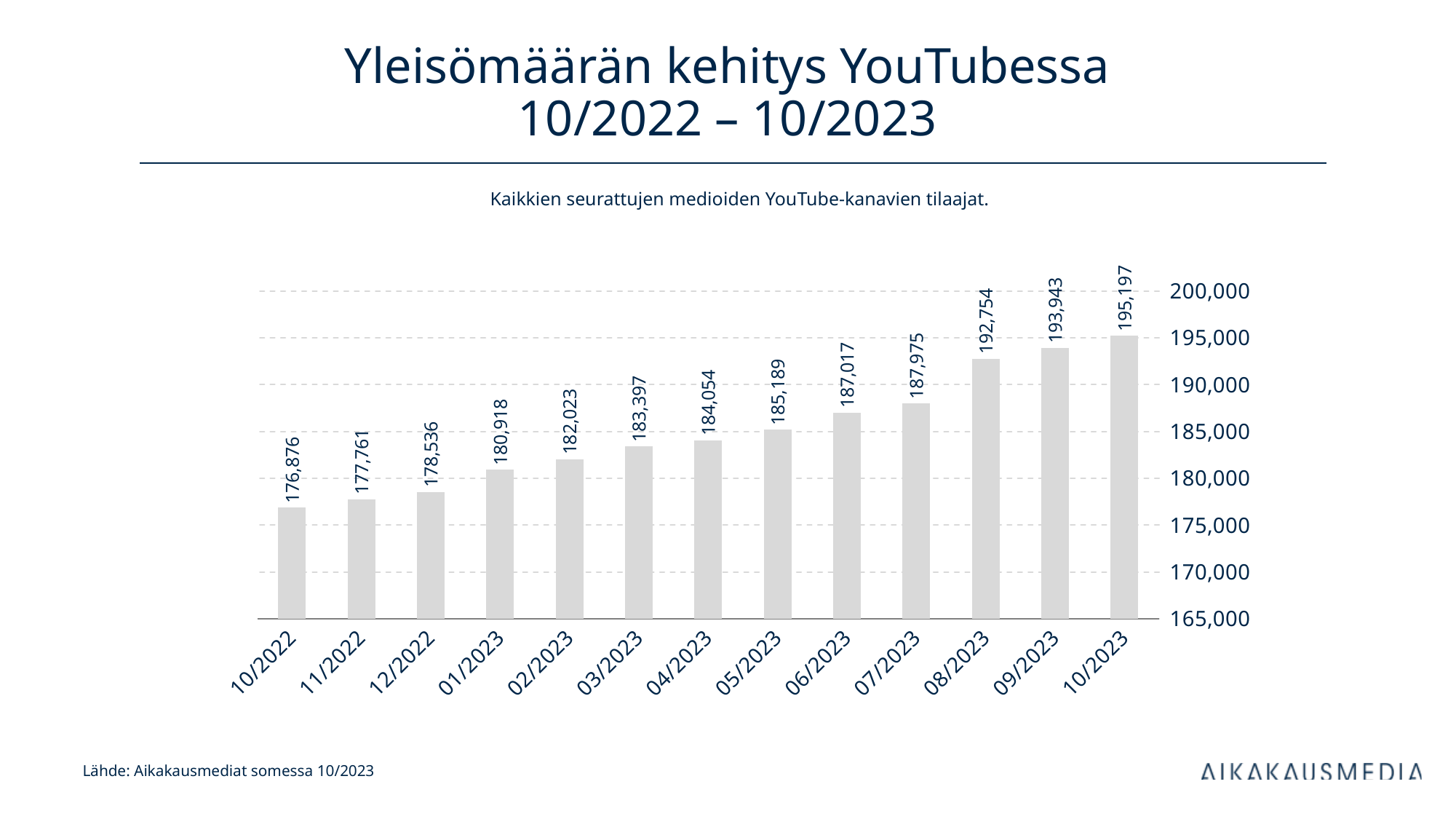
What kind of chart is shown on the slide? bar chart Do the values rise or fall from 10/2022 to 10/2023? rise Which month has the highest value? 10/2023 Which is larger, the value for 03/2023 or the value for 06/2023? 06/2023 What is the difference between the values for 10/2023 and 10/2022? 18,321 How many months are shown on the x axis? 13 What is the value for 10/2022? 176,876 What is the value for 08/2023? 192,754 What is the difference between the values for 08/2023 and 07/2023? 4,779 Is the value for 01/2023 greater or less than 180,000? greater Which month has the lowest value? 10/2022 What is the value for 05/2023? 185,189